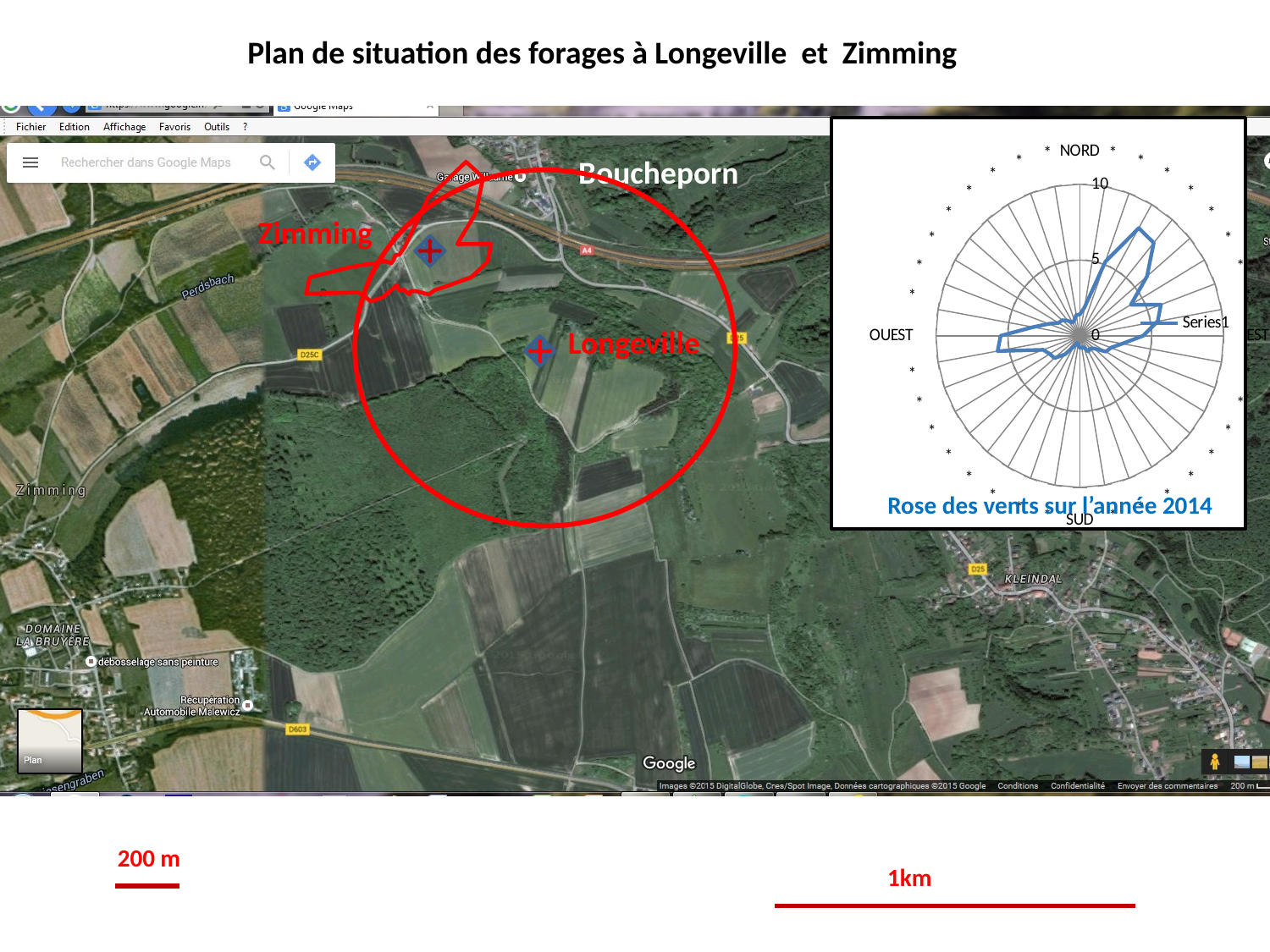
In the wind rose chart, is the largest value (toward the north-east) greater or less than 5? greater What is the highest radial tick value shown on the wind rose chart? 10 What is the name of the series shown in the legend of the wind rose chart? Series1 In the wind rose chart, is the value in the SUD direction greater or less than 5? less What kind of chart is shown in the inset on the right of the slide? radar chart In the wind rose chart, is the largest value greater or less than 10? less Toward which compass quadrant does the wind rose chart extend furthest? north-east (between NORD and EST) What is the title written under the wind rose chart? Rose des vents sur l'année 2014 How many series does the legend of the wind rose chart list? 1